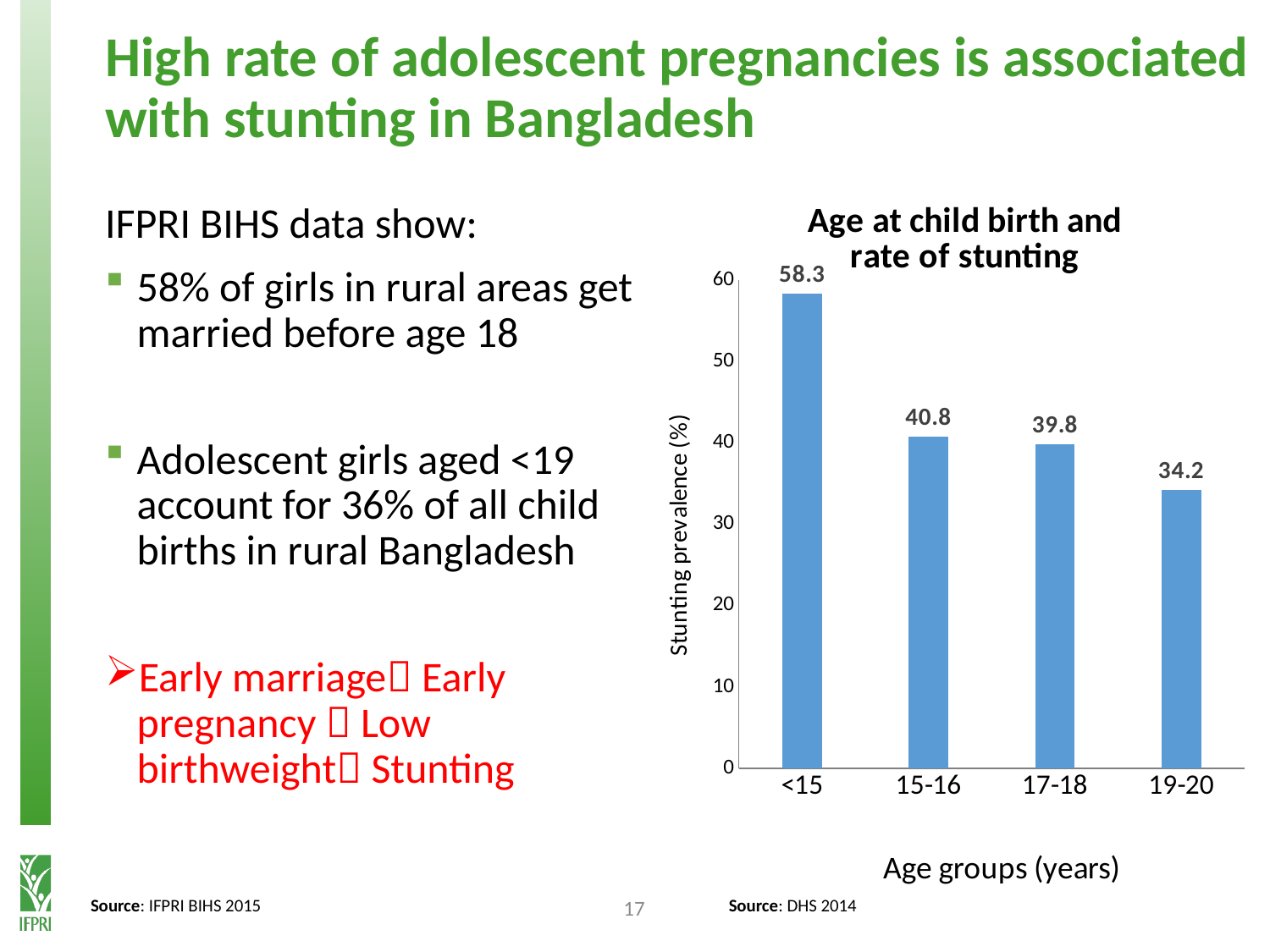
Which age group has the highest stunting prevalence? <15 What is the difference in stunting prevalence between the 15-16 and 17-18 age groups? 1.0 What kind of chart is shown on the slide? Bar chart Which has a higher stunting prevalence, the <15 group or the 17-18 group? <15 What is the stunting prevalence for the <15 age group? 58.3 What is the title of the chart? Age at child birth and rate of stunting Does stunting prevalence rise or fall as the age group at child birth increases? Fall What is the difference in stunting prevalence between the <15 and 19-20 age groups? 24.1 What is the stunting prevalence for the 15-16 age group? 40.8 Which age group has the lowest stunting prevalence? 19-20 What is the stunting prevalence for the 19-20 age group? 34.2 How many age groups are shown in the chart? 4